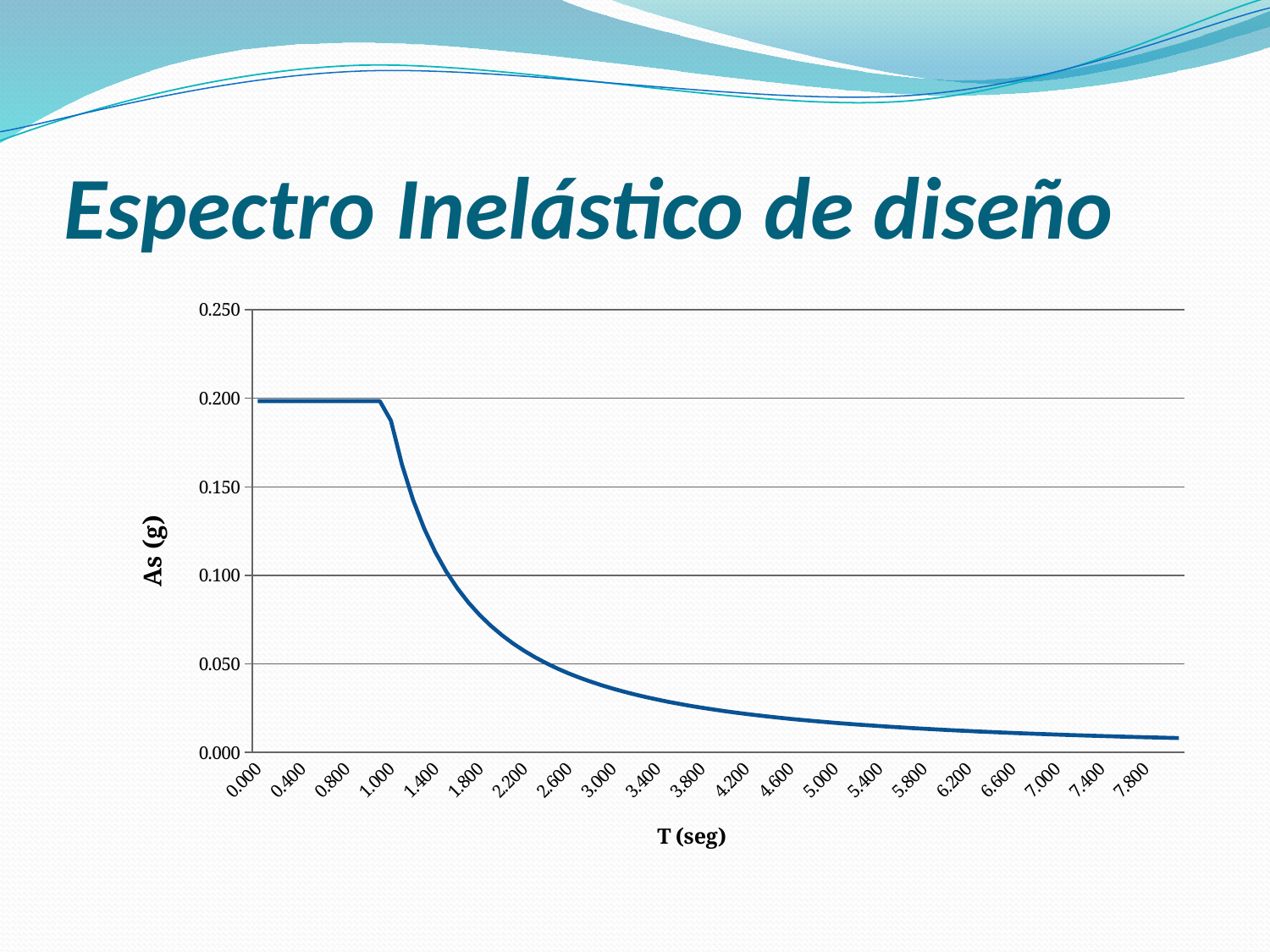
Is the value of As (g) at T = 3.000 greater or less than 0.050? less Is the value of As (g) at T = 7.800 greater or less than 0.050? less What is the label of the vertical axis? As (g) Does the value of As (g) rise or fall as T (seg) increases beyond 1.000? fall Is the value of As (g) at T = 2.200 greater or less than 0.050? greater What is the title of the slide containing the chart? Espectro Inelástico de diseño At what value of T (seg) does the curve stop being flat and begin to decrease? 1.000 What kind of chart is shown on the slide? line chart Which is larger, the value of As (g) at T = 1.000 or at T = 2.600? T = 1.000